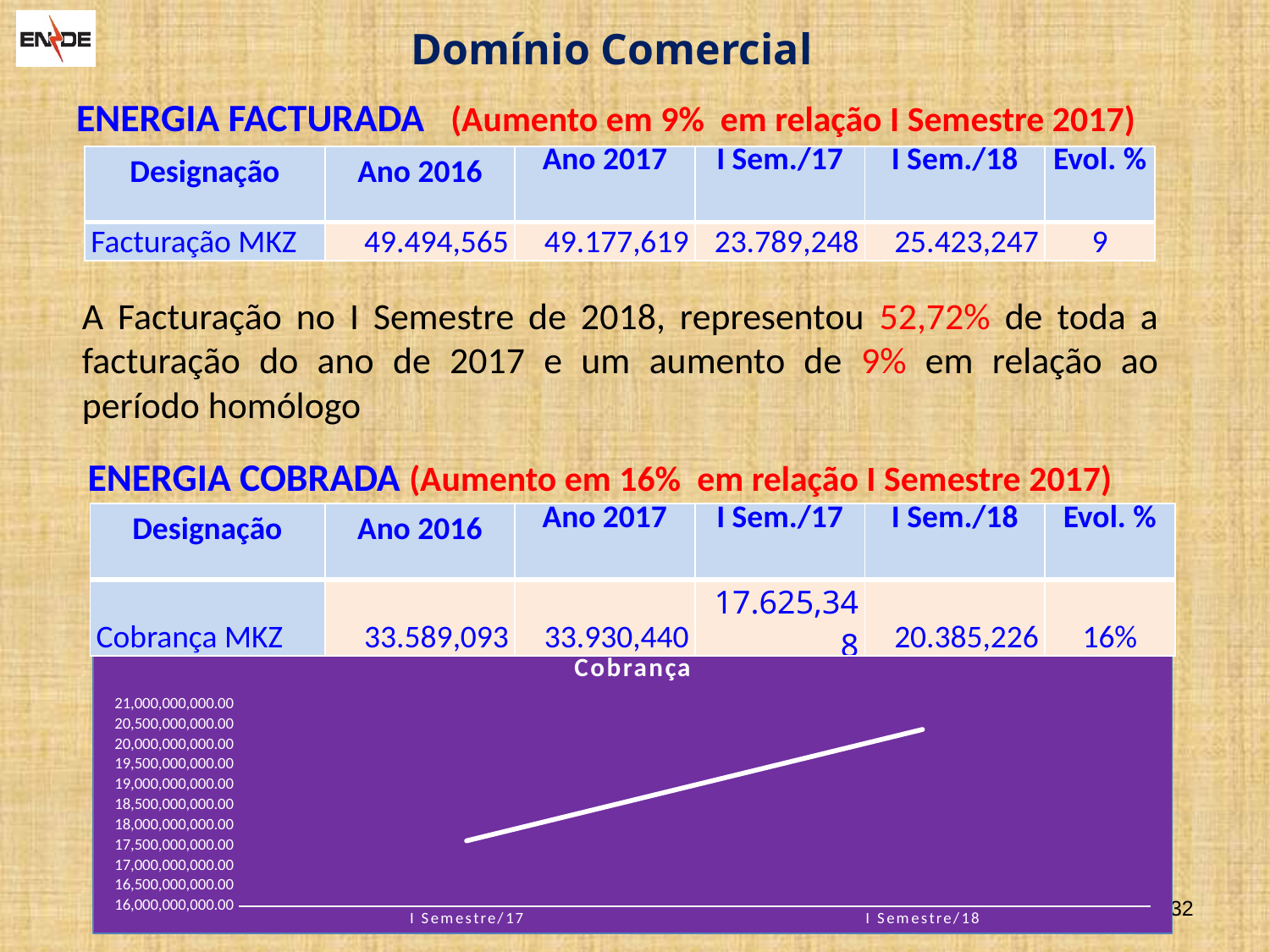
On the Cobrança chart, is the value for I Semestre/18 greater or less than 21,000,000,000.00? less On the Cobrança chart, is the value for I Semestre/17 greater or less than 18,000,000,000.00? less Does the line on the Cobrança chart rise or fall from I Semestre/17 to I Semestre/18? rise What kind of chart is shown at the bottom of the slide? line chart On the Cobrança chart, is the value for I Semestre/17 greater or less than 17,000,000,000.00? greater What is the title of the chart at the bottom of the slide? Cobrança On the Cobrança chart, which x-axis category has the highest value? I Semestre/18 On the Cobrança chart, which x-axis category has the lowest value? I Semestre/17 How many points are plotted on the Cobrança chart? 2 What is the lowest value shown on the y-axis of the Cobrança chart? 16,000,000,000.00 On the Cobrança chart, which point is higher: I Semestre/17 or I Semestre/18? I Semestre/18